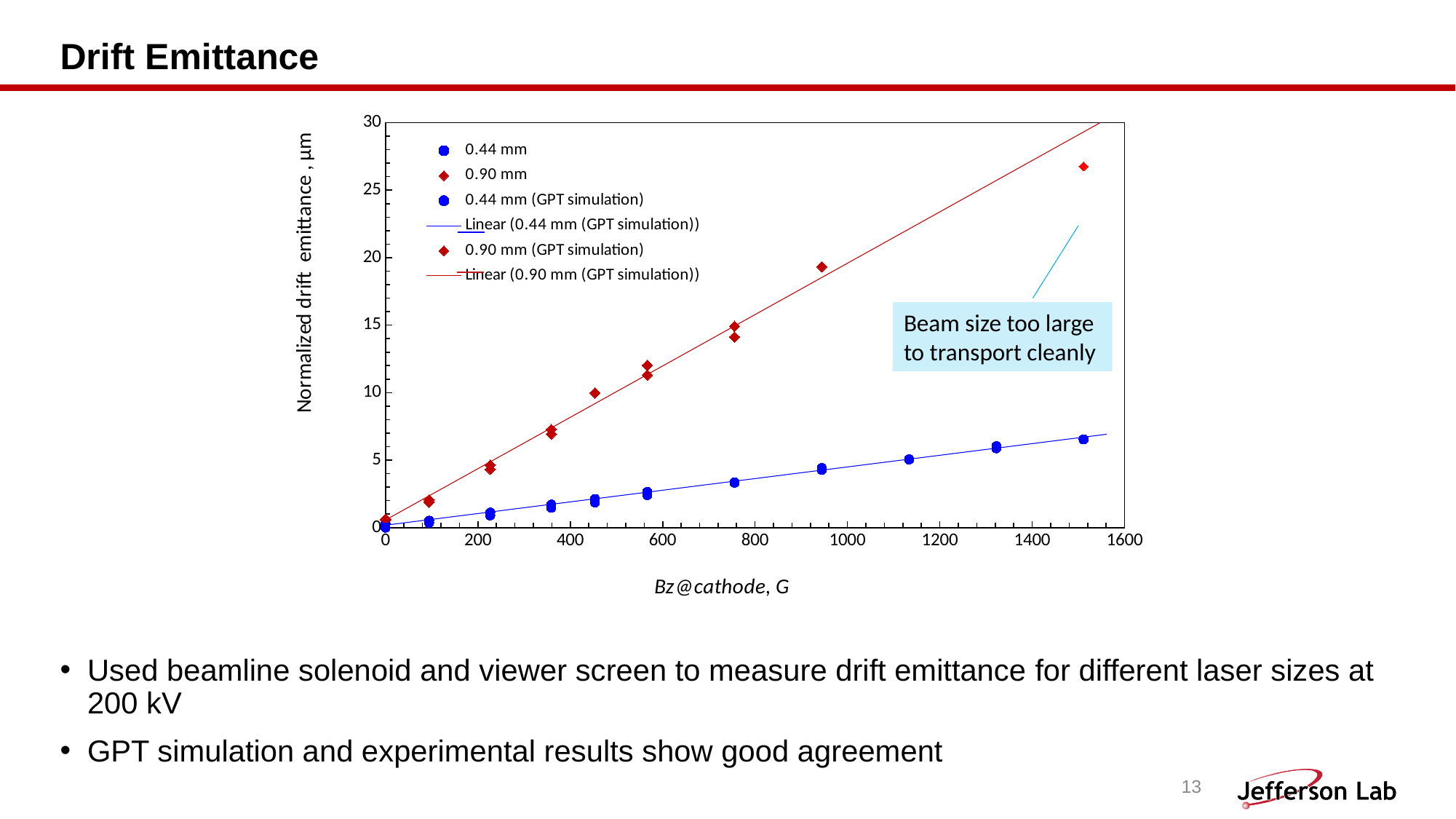
Do the normalized drift emittance values rise or fall as Bz@cathode increases? rise Is the value of the 0.90 mm data point near 1500 G greater or less than 25? greater Which laser size series reaches the highest normalized drift emittance, 0.44 mm or 0.90 mm? 0.90 mm What kind of chart is shown on the slide? scatter plot Is the value of the 0.44 mm data point near 1500 G greater or less than 10? less At about 1500 G, is the normalized drift emittance larger for the 0.90 mm series or the 0.44 mm series? 0.90 mm How many entries does the chart legend list? 6 Is the value of the 0.90 mm data point near 950 G greater or less than 20? less What is the label of the y axis of the chart? Normalized drift emittance, µm What is the label of the x axis of the chart? Bz@cathode, G